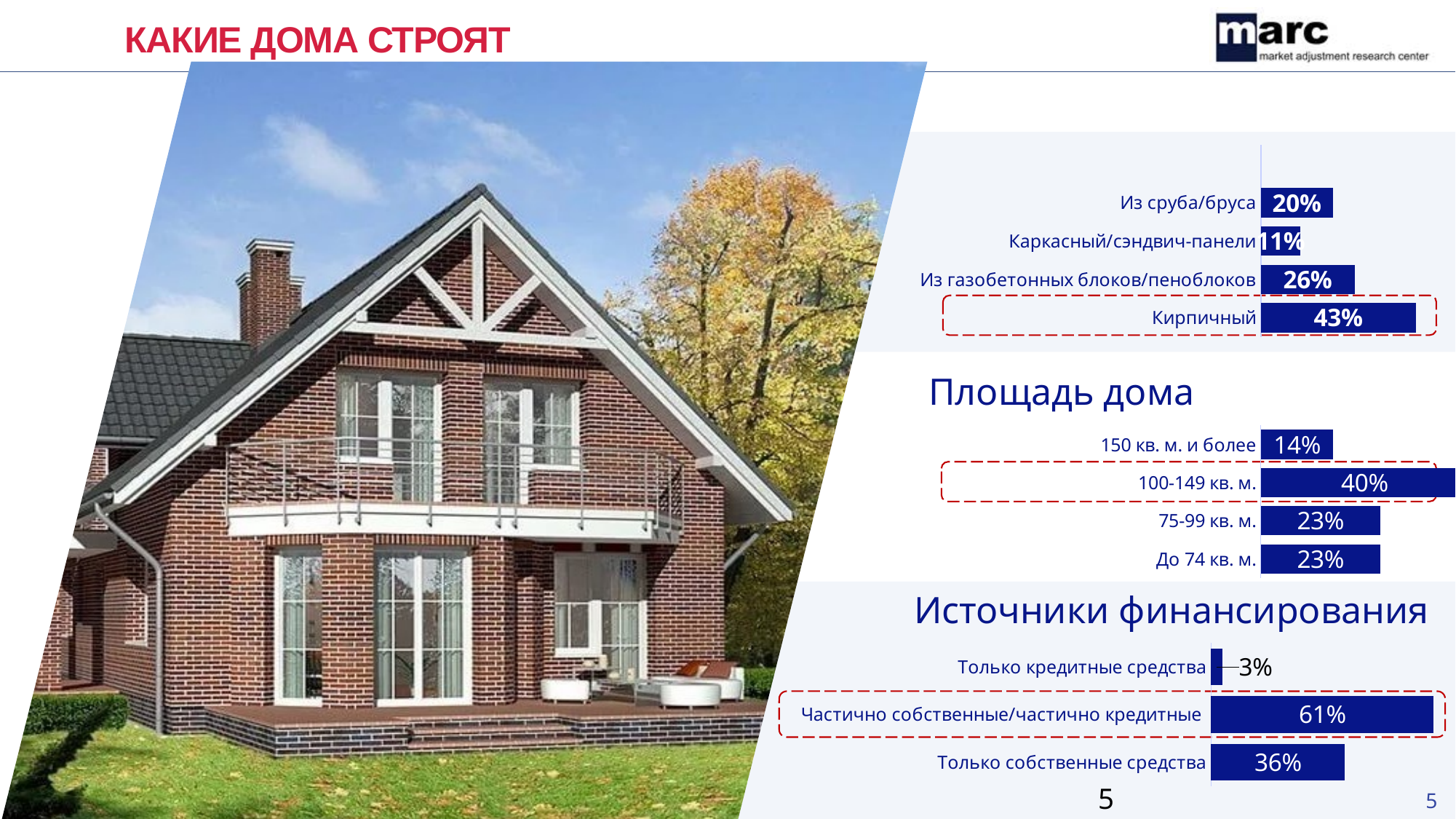
In the top chart on the right, which category has the lowest value? Каркасный/сэндвич-панели In the chart titled Источники финансирования, what is the difference between Частично собственные/частично кредитные and Только собственные средства? 25% In the chart titled Площадь дома, which is larger: 150 кв. м. и более or 75-99 кв. м.? 75-99 кв. м. How many categories does the chart titled Площадь дома show? 4 How many categories does the top chart on the right show? 4 What kind of chart is the chart titled Источники финансирования? Bar chart In the chart titled Площадь дома, which category has the highest value? 100-149 кв. м. In the chart titled Источники финансирования, what is the value for Только собственные средства? 36% In the chart titled Площадь дома, what is the value for 100-149 кв. м.? 40% In the top chart on the right, what is the difference between Кирпичный and Из сруба/бруса? 23% In the chart titled Источники финансирования, which category has the lowest value? Только кредитные средства In the top chart on the right, what is the value for Кирпичный? 43%